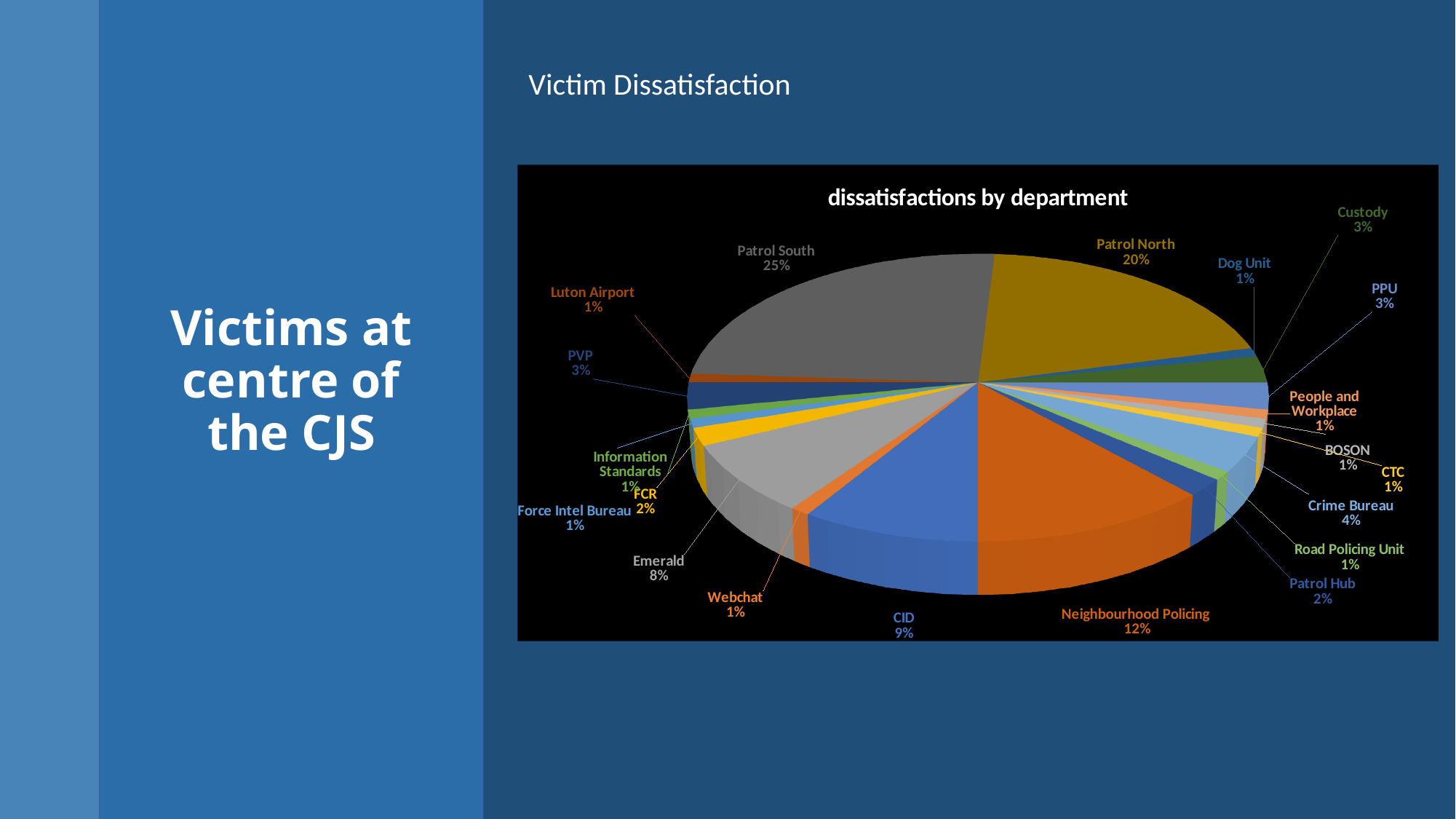
Which has a larger share, CID or Emerald? CID What percentage is shown for Neighbourhood Policing? 12% What type of chart is shown on the slide? Pie chart What is the difference in percentage points between Patrol South and Patrol North? 5 Which has a larger share, Neighbourhood Policing or Crime Bureau? Neighbourhood Policing How many departments are shown in the pie chart? 20 What percentage is shown for FCR? 2% What percentage is shown for Emerald? 8% What is the title of the chart? dissatisfactions by department What percentage is shown for Crime Bureau? 4% Which department has the largest share of dissatisfactions? Patrol South What share of dissatisfactions does Patrol South account for? 25%